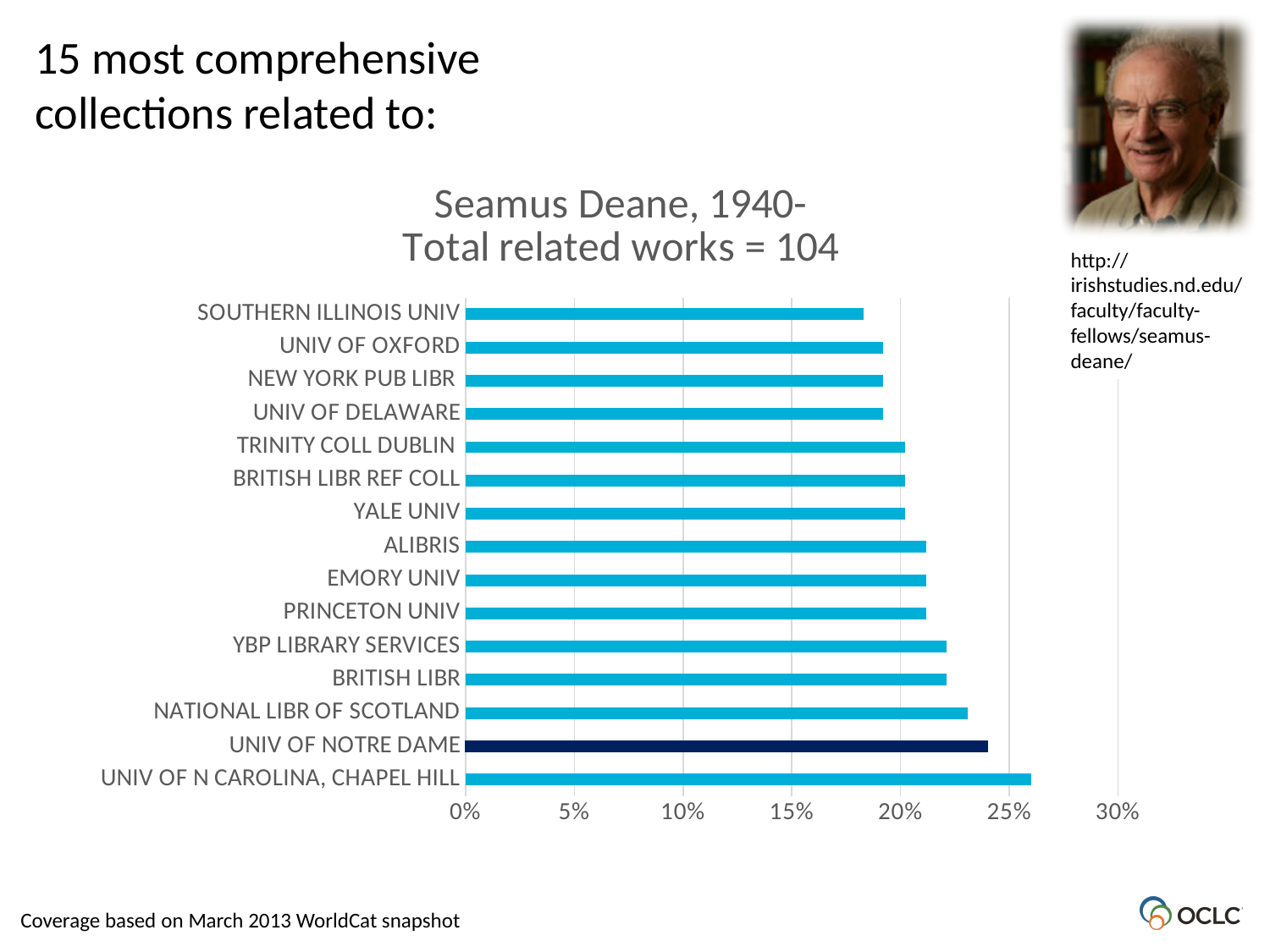
Is the value for UNIV OF NOTRE DAME greater or less than 25%? less How many institutions are listed in the chart? 15 Is the value for NATIONAL LIBR OF SCOTLAND greater or less than 20%? greater Is the value for SOUTHERN ILLINOIS UNIV greater or less than 20%? less What kind of chart is shown on the slide? bar chart Which institution has the lowest value in the chart? SOUTHERN ILLINOIS UNIV Which institution's bar is shown in a darker colour than the others? UNIV OF NOTRE DAME According to the chart title, what is the total number of related works? 104 Which has the larger value, UNIV OF N CAROLINA, CHAPEL HILL or UNIV OF NOTRE DAME? UNIV OF N CAROLINA, CHAPEL HILL Which institution has the highest value in the chart? UNIV OF N CAROLINA, CHAPEL HILL Which has the larger value, NATIONAL LIBR OF SCOTLAND or YALE UNIV? NATIONAL LIBR OF SCOTLAND